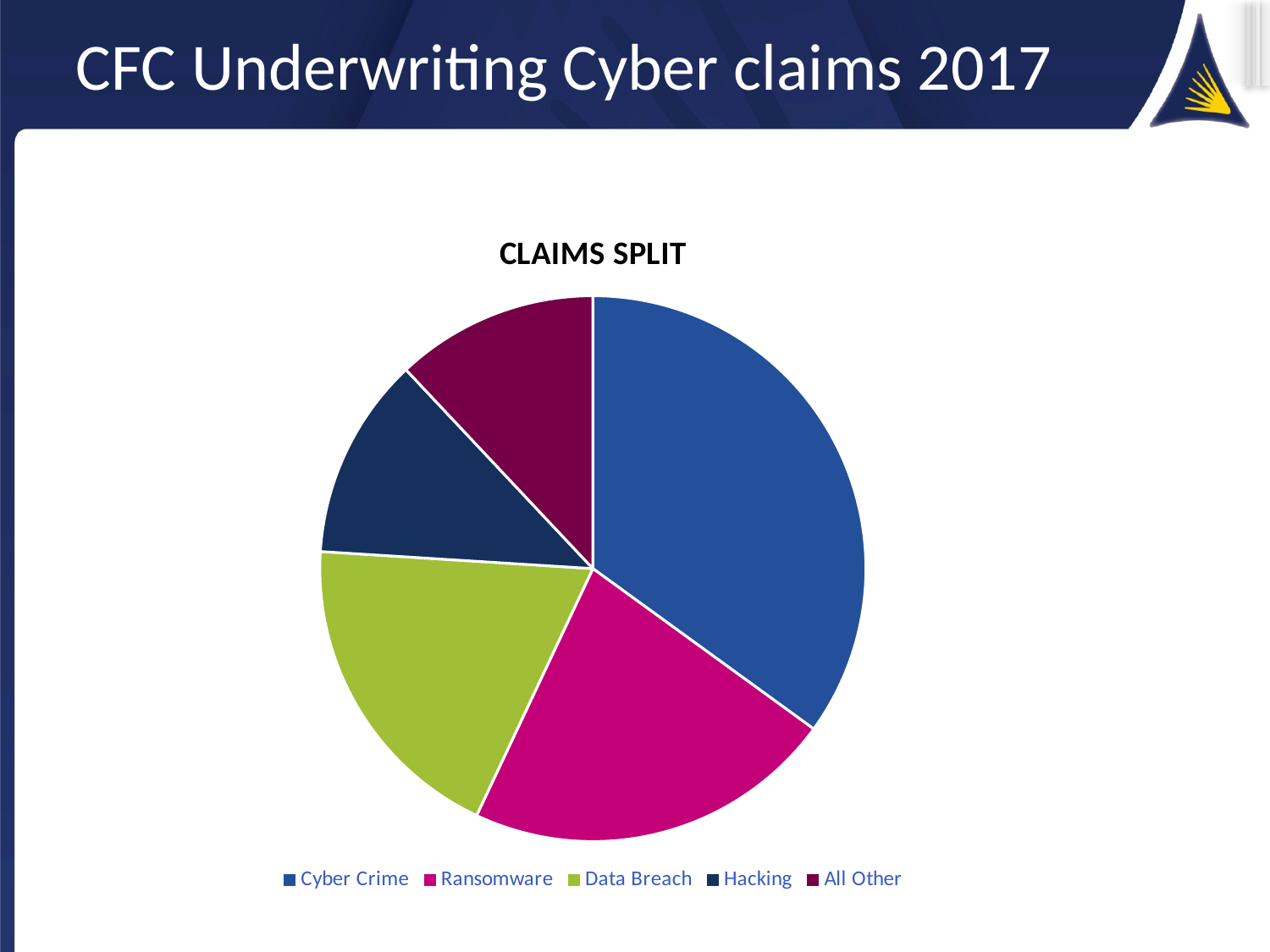
Which slice is larger, Ransomware or All Other? Ransomware What kind of chart is shown on the slide? Pie chart Which slice is larger, Cyber Crime or Ransomware? Cyber Crime Which category has the largest slice of the pie? Cyber Crime Which slice is larger, Cyber Crime or Data Breach? Cyber Crime How many entries does the legend list? 5 Which category is shown in green in the pie chart? Data Breach What is the title of the chart? CLAIMS SPLIT How many slices does the pie chart have? 5